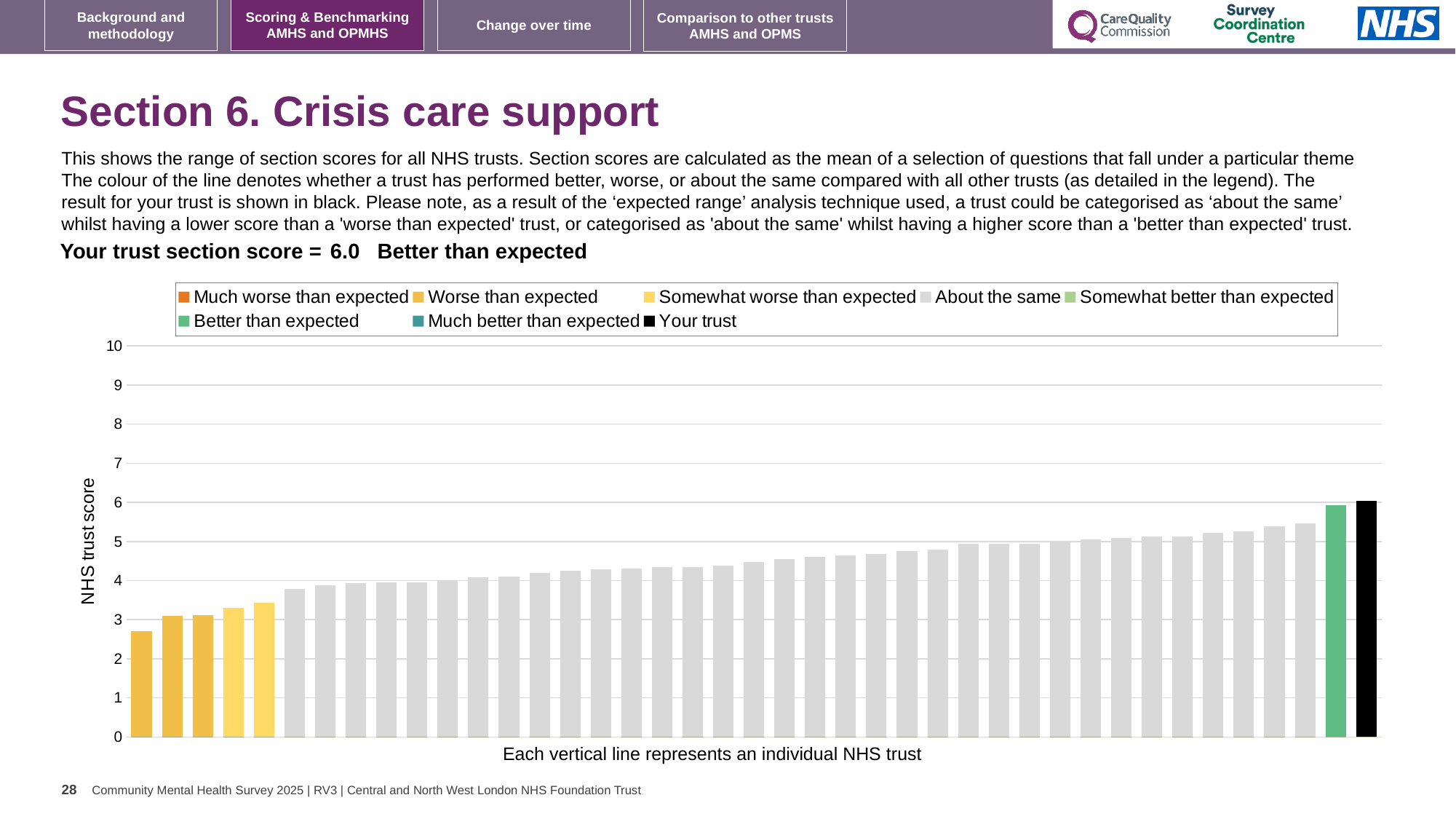
What is the label on the y axis of the chart? NHS trust score Is the value of the leftmost bar greater or less than 3? less What type of chart is shown on the slide? Bar chart Is the value of the 'Your trust' bar greater or less than 5? greater Which category does your trust fall into according to the slide? Better than expected How many bars are coloured as 'Worse than expected'? 3 How many bars are coloured as 'Somewhat worse than expected'? 2 Do the bar values rise or fall from left to right along the x axis? Rise What is the section score for your trust shown on the slide? 6.0 How many entries does the chart legend list? 8 Is the value of the 'Better than expected' (green) bar greater or less than 5? greater Which is larger, the leftmost bar or the rightmost bar? The rightmost bar